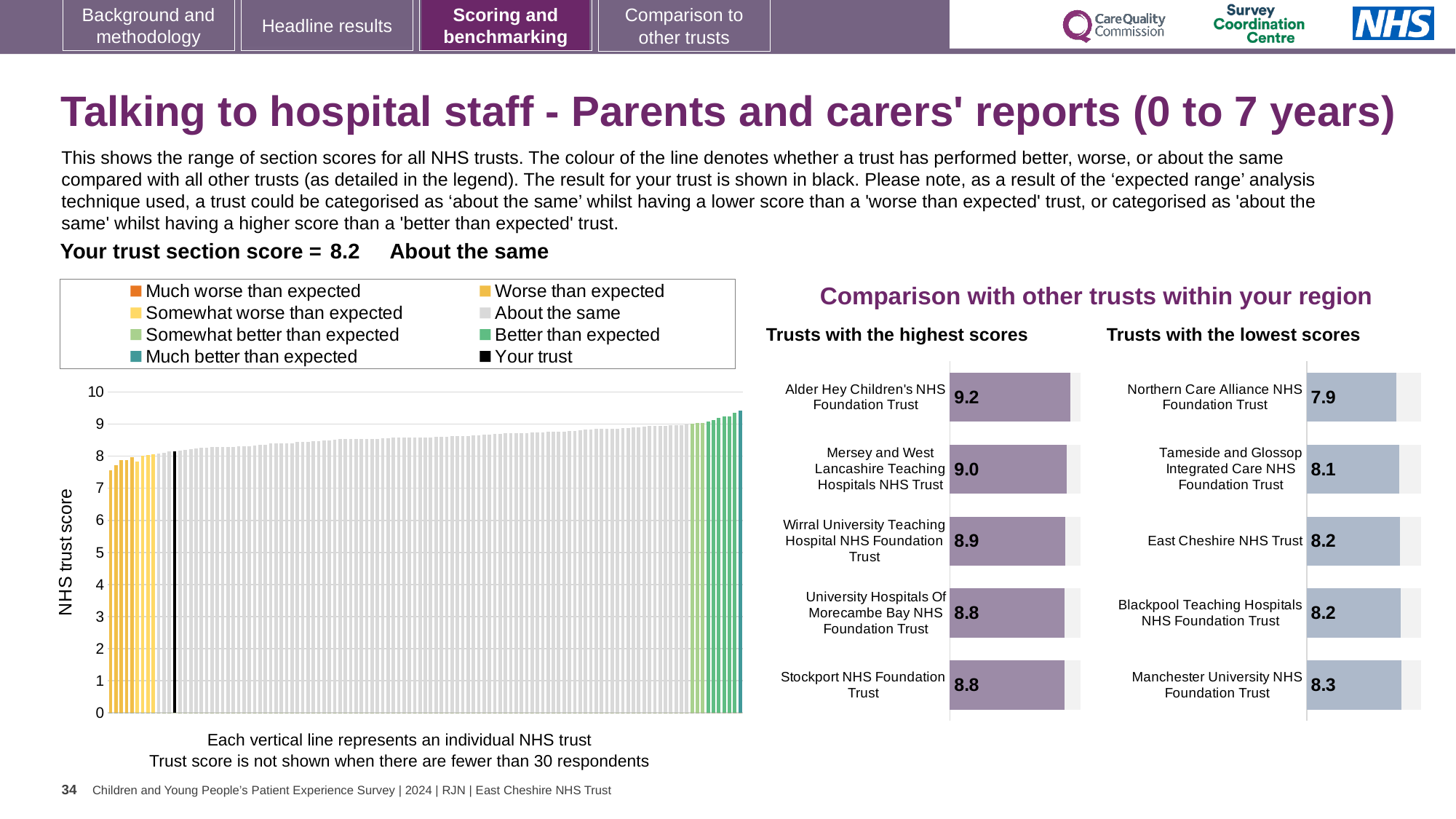
In the 'Trusts with the highest scores' chart, which has the larger score: Mersey and West Lancashire Teaching Hospitals NHS Trust or Wirral University Teaching Hospital NHS Foundation Trust? Mersey and West Lancashire Teaching Hospitals NHS Trust In the 'Trusts with the lowest scores' chart, which trust has the lowest score? Northern Care Alliance NHS Foundation Trust How many entries does the legend above the large 'NHS trust score' chart list? 8 In the 'Trusts with the highest scores' chart, which trust has the highest score? Alder Hey Children's NHS Foundation Trust In the 'Trusts with the highest scores' chart, what is the difference between the scores of Alder Hey Children's NHS Foundation Trust and Stockport NHS Foundation Trust? 0.4 In the 'Trusts with the lowest scores' chart, what is the score for Northern Care Alliance NHS Foundation Trust? 7.9 In the large 'NHS trust score' chart on the left, do the trust scores rise or fall from left to right? Rise What kind of chart is the large 'NHS trust score' chart on the left of the slide? Bar chart In the 'Trusts with the highest scores' chart, what is the score for Alder Hey Children's NHS Foundation Trust? 9.2 How many trusts are shown in the 'Trusts with the highest scores' chart? 5 In the 'Trusts with the lowest scores' chart, what is the score for Manchester University NHS Foundation Trust? 8.3 In the 'Trusts with the lowest scores' chart, what is the difference between the scores of Manchester University NHS Foundation Trust and Northern Care Alliance NHS Foundation Trust? 0.4